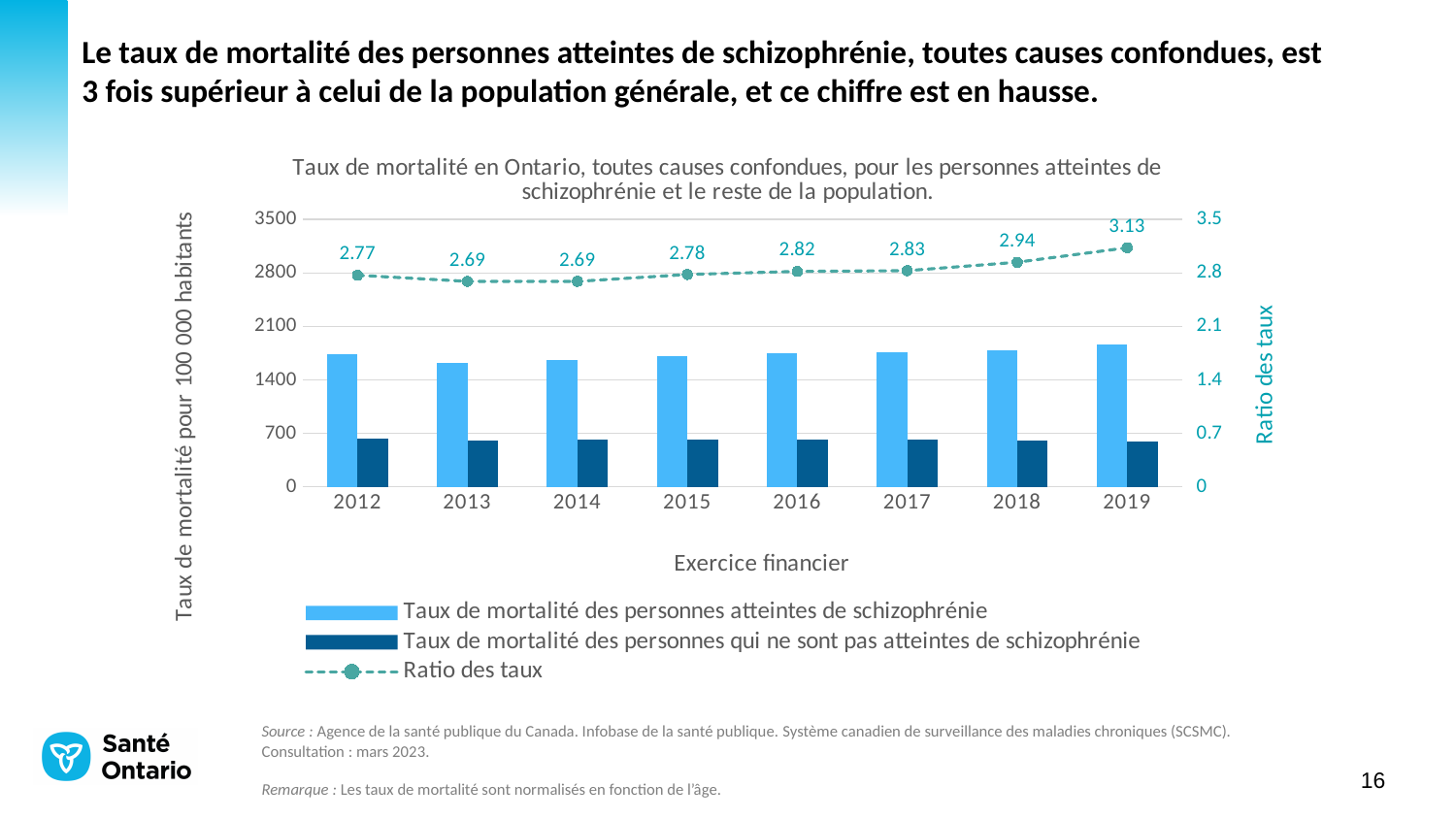
Does the Ratio des taux rise or fall overall from 2012 to 2019? rise In which year is the Ratio des taux highest? 2019 How many fiscal years are shown on the x axis? 8 How many series does the legend list? 3 Is the value for Taux de mortalité des personnes qui ne sont pas atteintes de schizophrénie in 2012 greater or less than 700? less What is the value of the Ratio des taux for 2019? 3.13 Which year has the larger Ratio des taux, 2017 or 2018? 2018 Is the value for Taux de mortalité des personnes atteintes de schizophrénie in 2019 greater or less than 1400? greater What is the difference between the Ratio des taux in 2019 and in 2012? 0.36 What is the value of the Ratio des taux for 2012? 2.77 What is the lowest value shown for the Ratio des taux? 2.69 What is the value of the Ratio des taux for 2016? 2.82